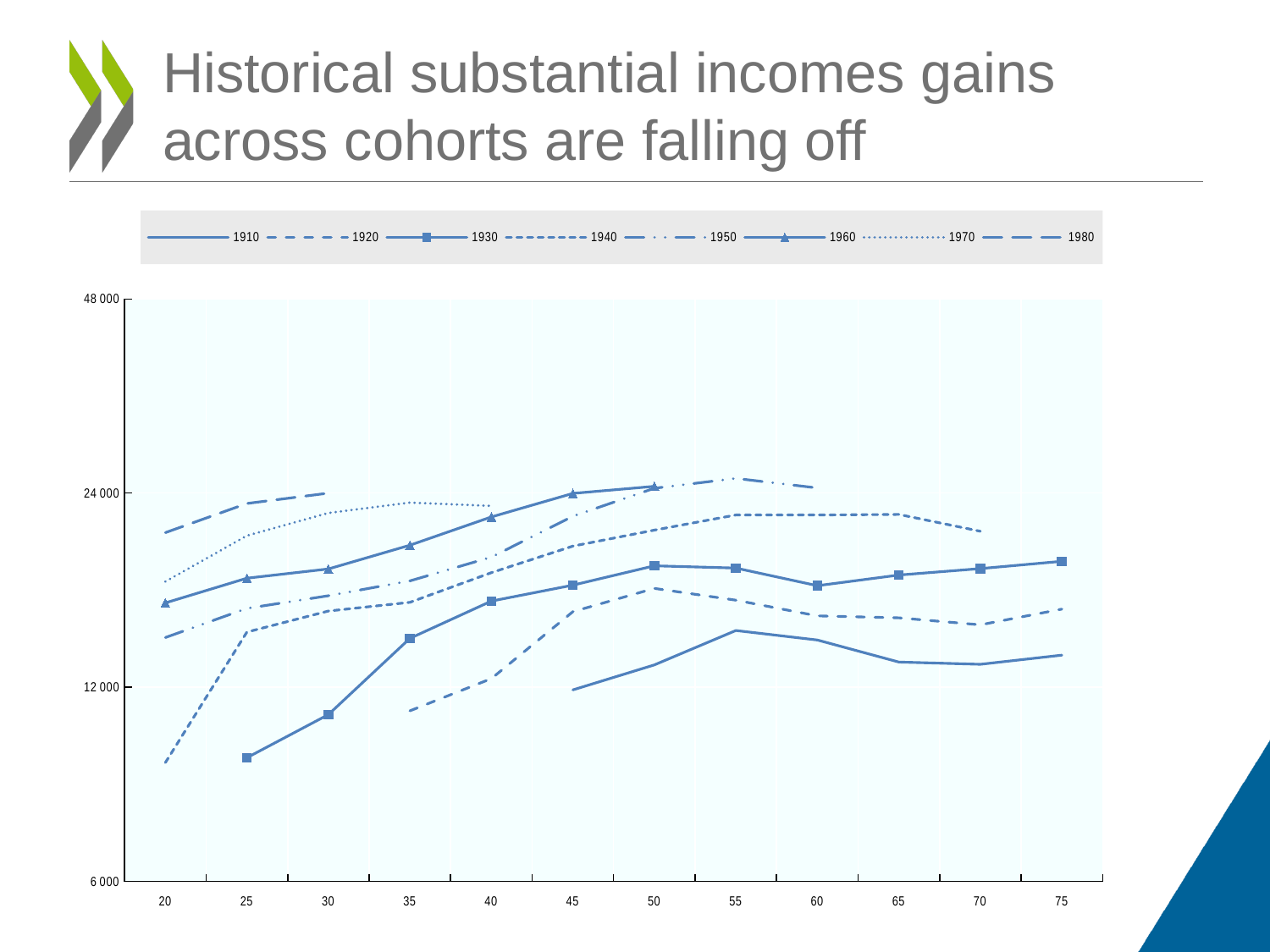
Is the value for the 1910 series at age 55 greater or less than 12 000? greater How many age values are labelled on the x axis? 12 Which series has the highest value at age 20? 1980 Does the 1930 series rise or fall between age 25 and age 50? rise At age 75, which is larger: the 1930 series or the 1910 series? 1930 Which series is plotted with square markers? 1930 Is the value for the 1930 series at age 25 greater or less than 12 000? less Is the value for the 1940 series at age 20 greater or less than 12 000? less How many series does the legend list? 8 Which series is plotted with triangle markers? 1960 Which series has the lowest value at age 25? 1930 What kind of chart is shown on the slide? line chart